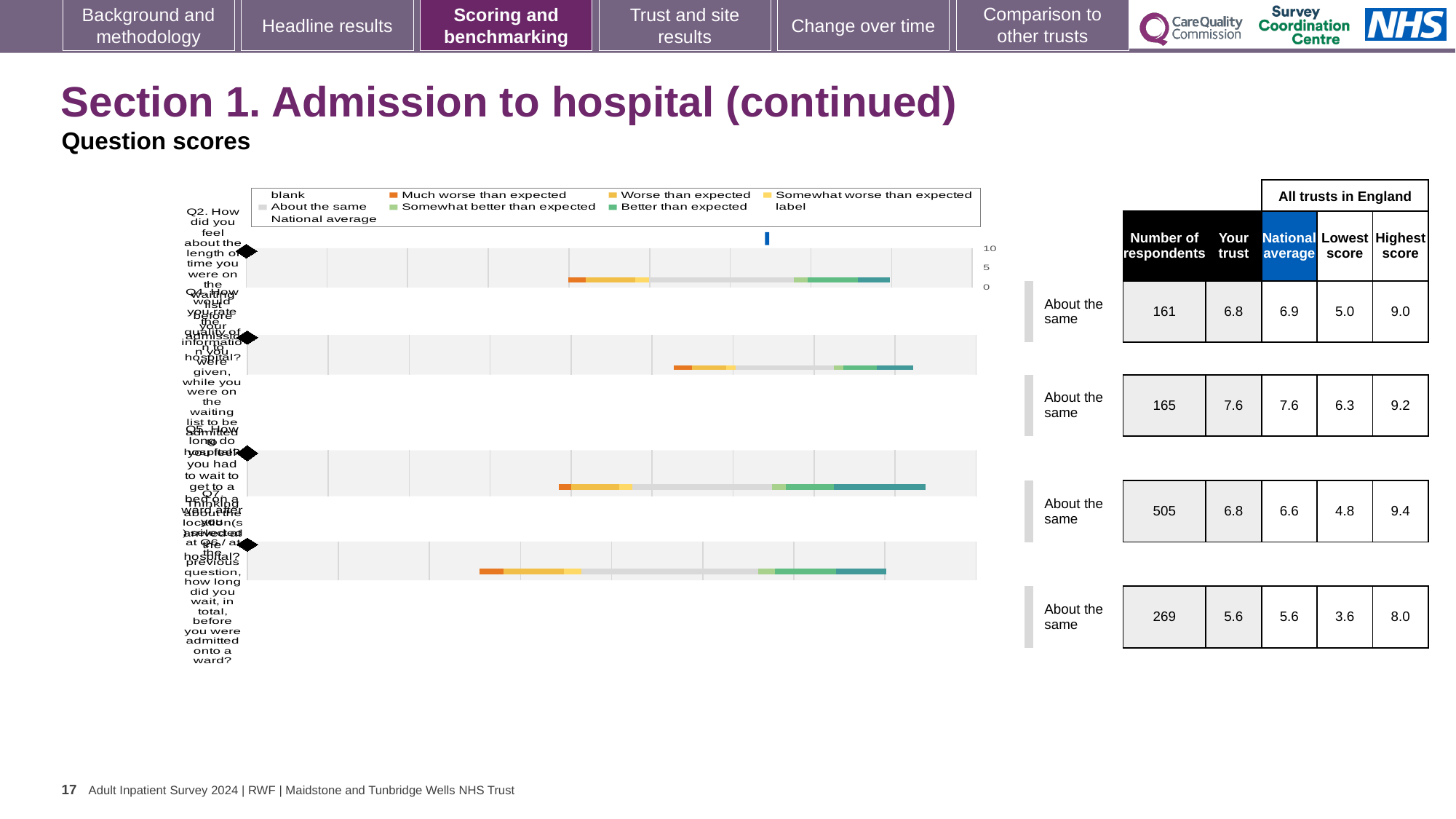
How many question rows (bars) are plotted in the chart? 4 In the table beside the chart, which row has the highest 'Highest score' value? the row with 505 respondents (9.4) In the table beside the chart, what is the 'Your trust' score for the row with 161 respondents? 6.8 What kind of chart is shown on the slide? bar chart What benchmark label is shown for each of the four question rows next to the chart? About the same In the table beside the chart, what is the smallest 'Lowest score' value? 3.6 In the table beside the chart, for the row with 505 respondents, which is larger: the 'Your trust' score or the national average? Your trust Which legend entry is shown in orange-red in the chart's legend? Much worse than expected In the table beside the chart, what is the difference between the highest score and the lowest score for the row with 165 respondents? 2.9 How many entries does the chart's legend list? 9 What is the highest tick value shown on the chart's score axis? 10 In the table beside the chart, what is the national average for the row with 505 respondents? 6.6